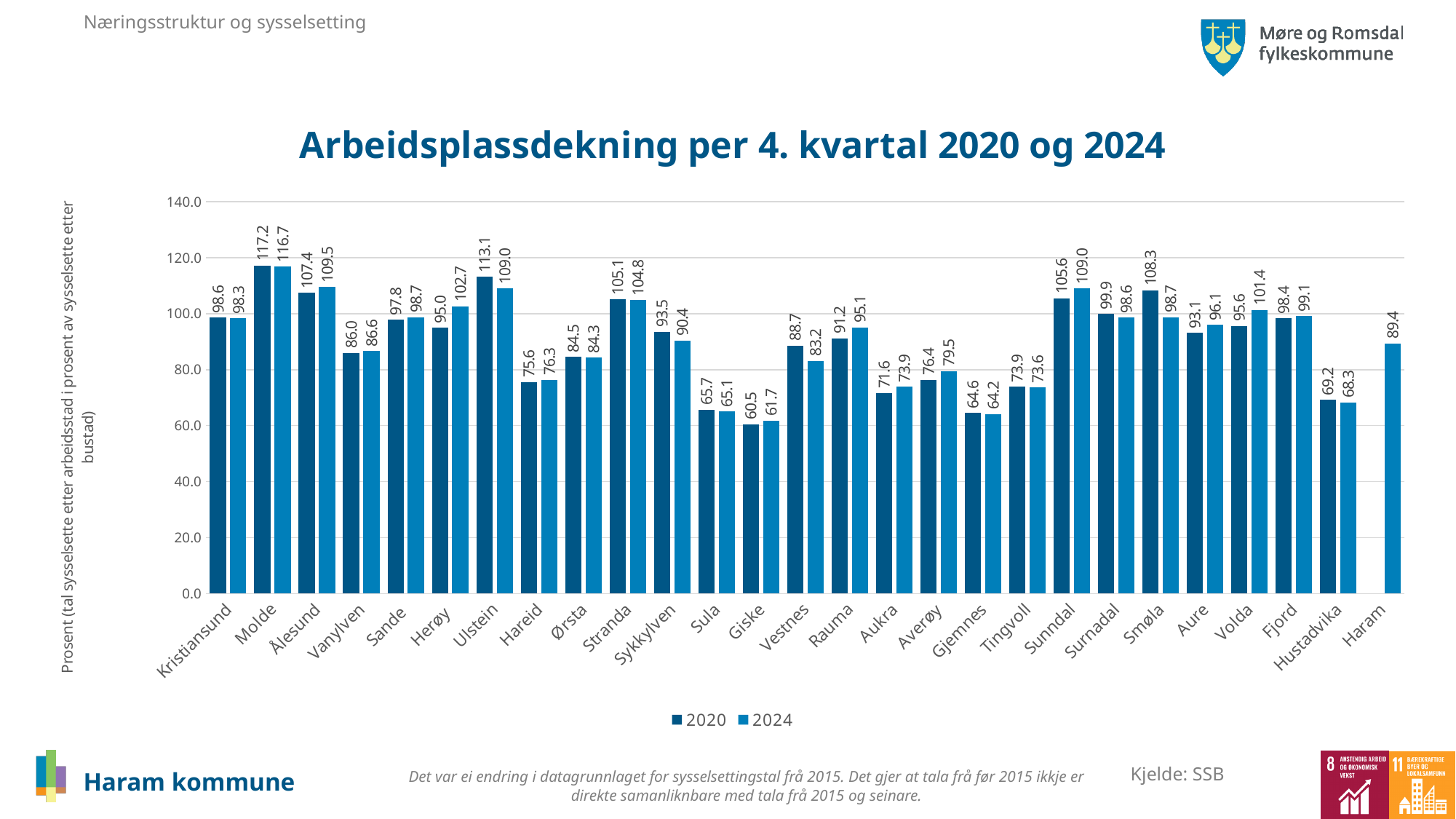
How many series does the legend list? 2 What is the 2024 value for Herøy? 102.7 Which municipality has the lowest 2024 value? Giske What is the value shown for Haram? 89.4 Which is larger for Vestnes, the 2020 value or the 2024 value? 2020 Which municipality has the highest 2020 value? Molde What is the 2020 value for Sunndal? 105.6 What is the title of the chart? Arbeidsplassdekning per 4. kvartal 2020 og 2024 Is the 2024 value for Ulstein greater or less than 100.0? greater How many municipalities are shown on the x axis? 27 What is the difference between the 2020 and 2024 values for Smøla? 9.6 What kind of chart is shown on the slide? bar chart